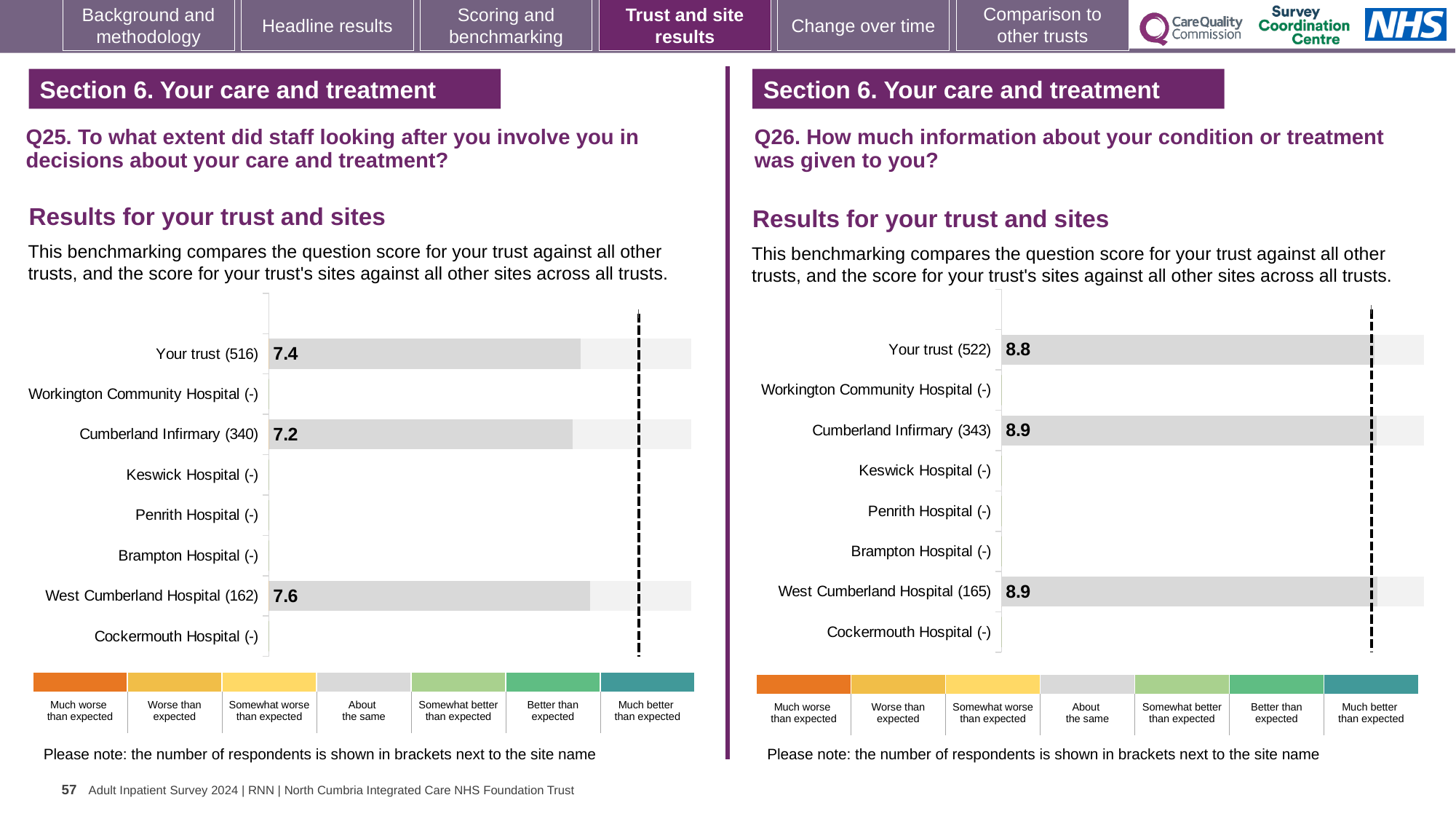
On the Q26 chart (right), what is the score for Your trust (522)? 8.8 What kind of chart is used on the Q26 chart (right)? Bar chart On the Q26 chart (right), what is the score for West Cumberland Hospital (165)? 8.9 On the Q25 chart (left), what is the score for Your trust (516)? 7.4 On the Q26 chart (right), what is the score for Cumberland Infirmary (343)? 8.9 On the Q25 chart (left), what is the score for West Cumberland Hospital (162)? 7.6 On the Q25 chart (left), which site with a plotted score has the lowest value? Cumberland Infirmary (340) On the Q25 chart (left), what is the score for Cumberland Infirmary (340)? 7.2 On the Q25 chart (left), which site with a plotted score has the highest value? West Cumberland Hospital (162) On the Q25 chart (left), what is the difference between the scores for West Cumberland Hospital (162) and Cumberland Infirmary (340)? 0.4 How many site/trust categories are listed on the Q25 chart (left)? 8 On the Q26 chart (right), which is larger: the score for Cumberland Infirmary (343) or Your trust (522)? Cumberland Infirmary (343)